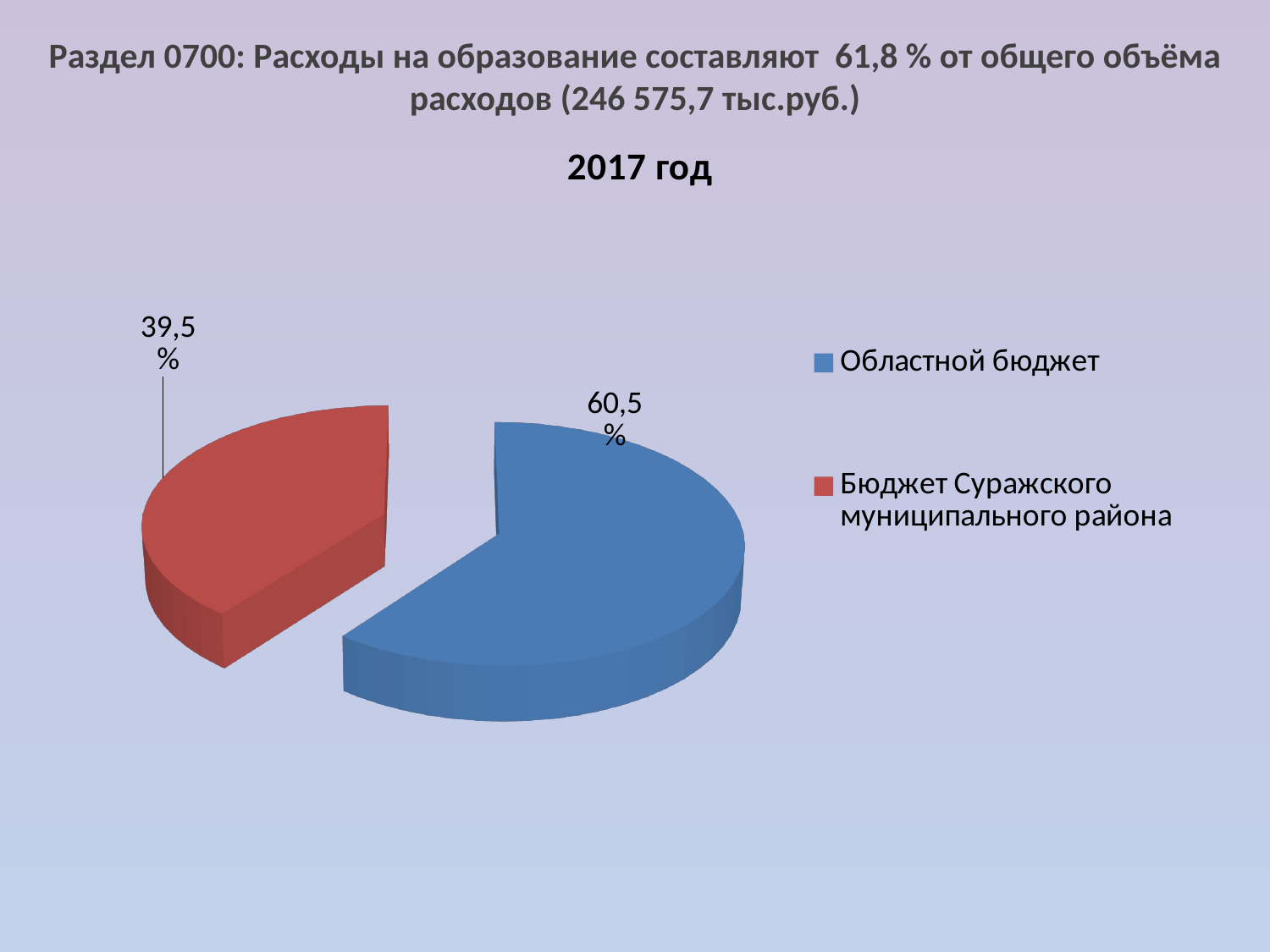
What colour is the slice for Областной бюджет? blue How many slices does the pie chart have? 2 What kind of chart is shown on the slide? pie chart What is the difference in percentage points between the Областной бюджет slice and the Бюджет Суражского муниципального района slice? 21 percentage points What year is shown in the chart title? 2017 год Which is larger: the share for Областной бюджет or the share for Бюджет Суражского муниципального района? Областной бюджет What share of the pie does Бюджет Суражского муниципального района have? 39,5 % What share of the pie does Областной бюджет have? 60,5 % Which category has the smallest slice of the pie? Бюджет Суражского муниципального района Which category has the largest slice of the pie? Областной бюджет How many entries does the legend list? 2